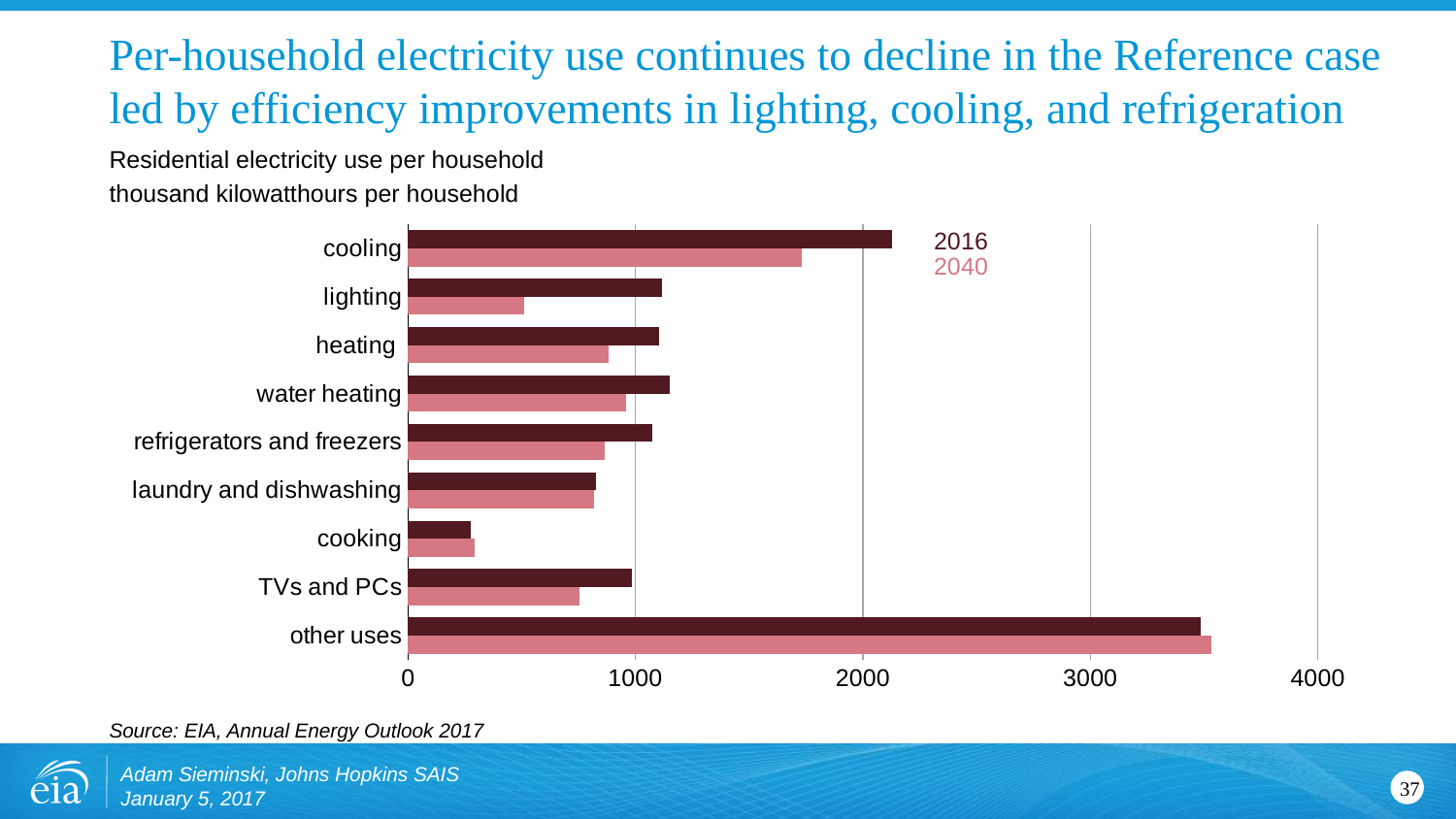
Is the 2016 value for cooking greater or less than 1000? less For cooling, which year has the larger value, 2016 or 2040? 2016 What kind of chart is shown on the slide? bar chart Is the 2040 value for lighting greater or less than 1000? less Which category has the highest value for 2016? other uses What unit is the chart measured in, according to the subtitle? thousand kilowatthours per household How many series does the legend list? 2 For lighting, which year has the larger value, 2016 or 2040? 2016 Which category has the lowest value for 2040? cooking Is the 2040 value for other uses greater or less than 3000? greater How many end-use categories are plotted on the chart? 9